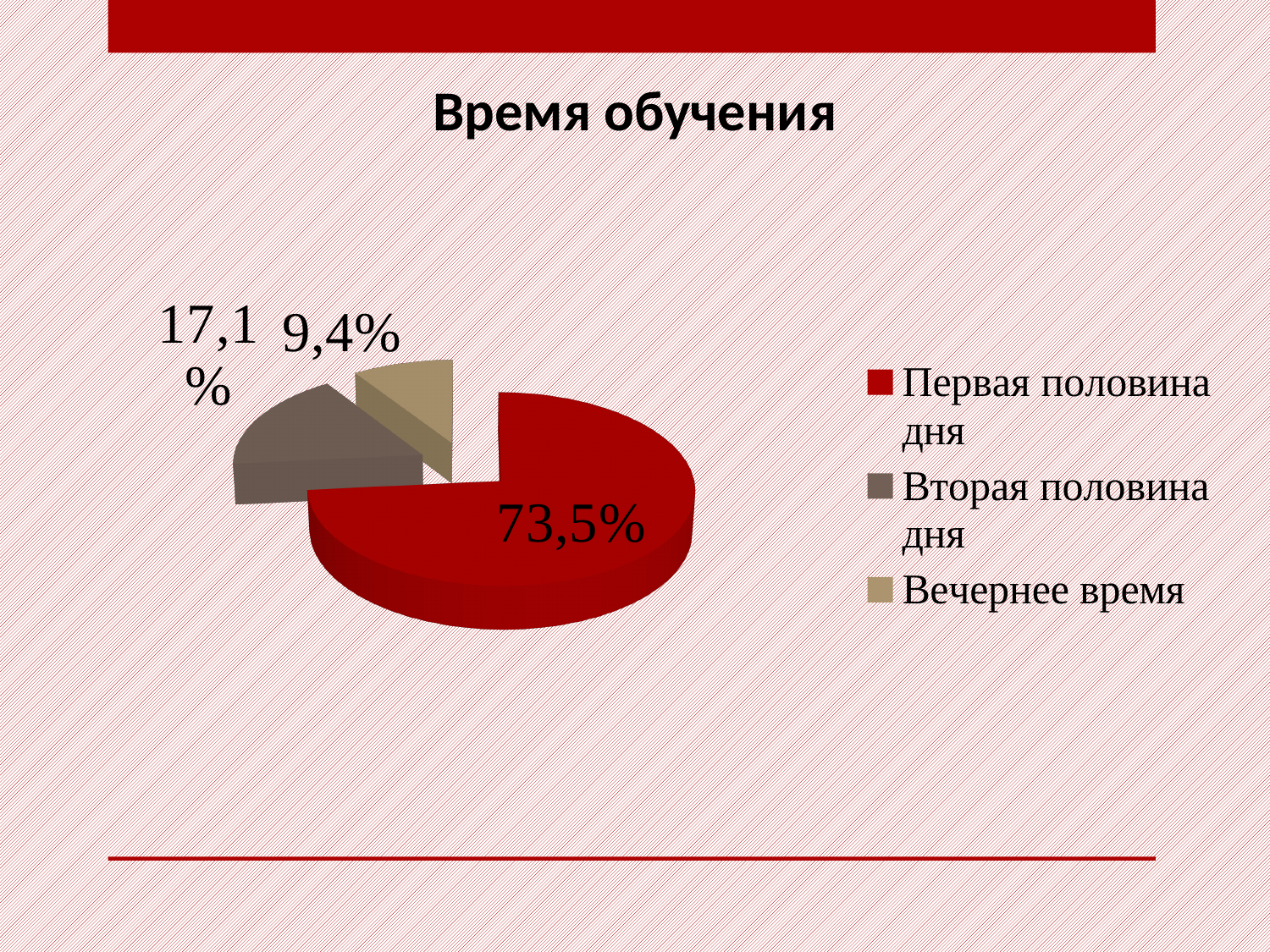
What share of the pie is labelled for Первая половина дня? 73,5% What share of the pie is labelled for Вечернее время? 9,4% What kind of chart is shown on the slide? pie chart What is the difference in percentage points between the slices for Первая половина дня and Вторая половина дня? 56,4 Which category has the largest slice of the pie? Первая половина дня What share of the pie is labelled for Вторая половина дня? 17,1% Which category has the smallest slice of the pie? Вечернее время How many slices does the pie chart have? 3 How many entries does the legend list? 3 What colour is the slice for Вечернее время? beige Which is larger, the slice for Вторая половина дня or the slice for Вечернее время? Вторая половина дня What is the title of the chart? Время обучения